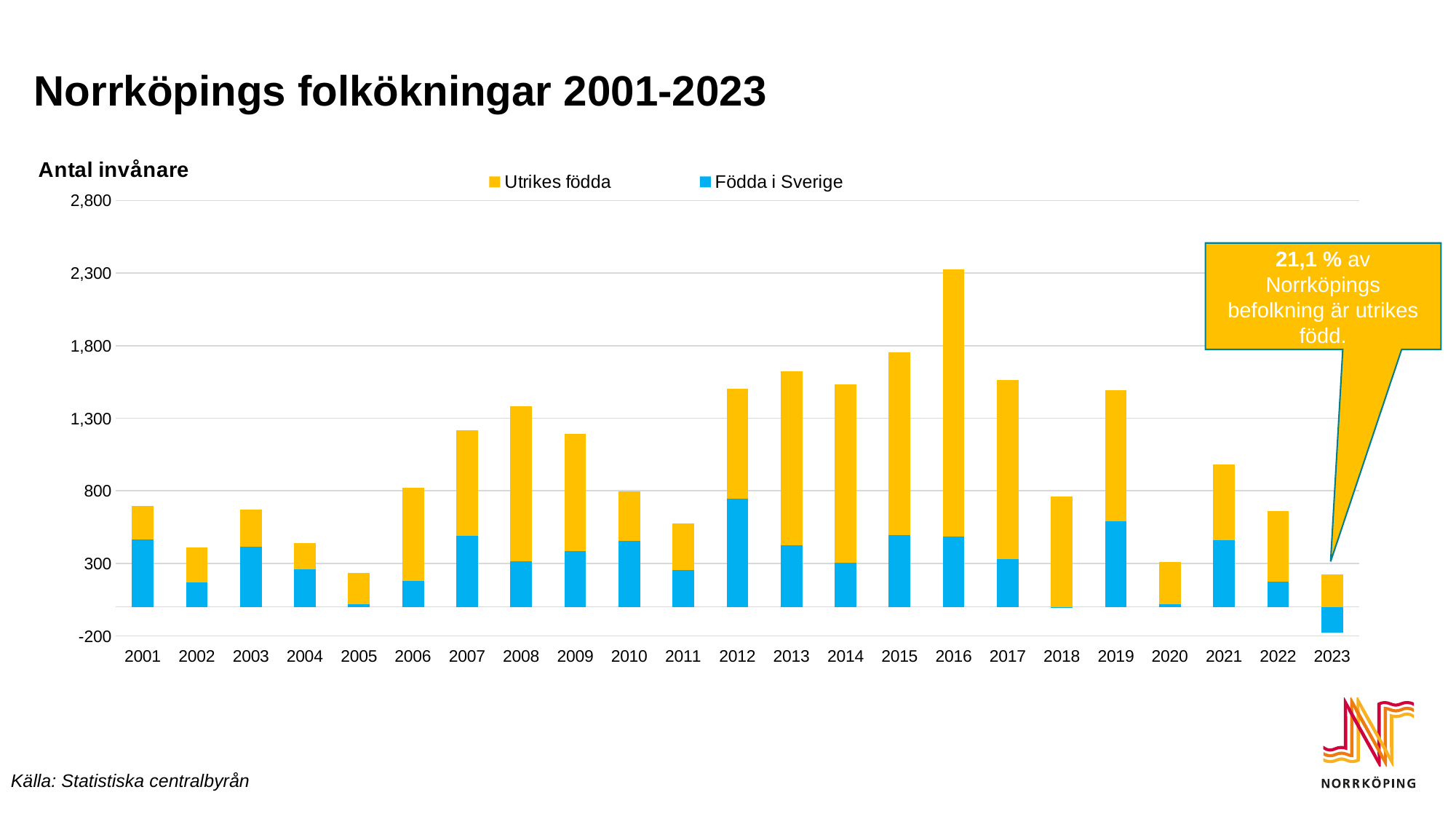
What kind of chart is shown on the slide? Stacked bar chart Which year has the tallest stacked bar in the chart? 2016 Which year has a negative value for Födda i Sverige? 2023 Is the total bar for 2020 greater or less than 800? less How many series does the chart legend list? 2 How many years are shown on the x axis of the chart? 23 Is the total bar for 2016 greater or less than 1,800? greater According to the callout on the chart, what share of Norrköping's population is foreign-born (utrikes född)? 21,1 % Which series is shown in yellow in the chart? Utrikes födda Is the total bar for 2005 greater or less than 300? less Which year has the taller total bar, 2014 or 2015? 2015